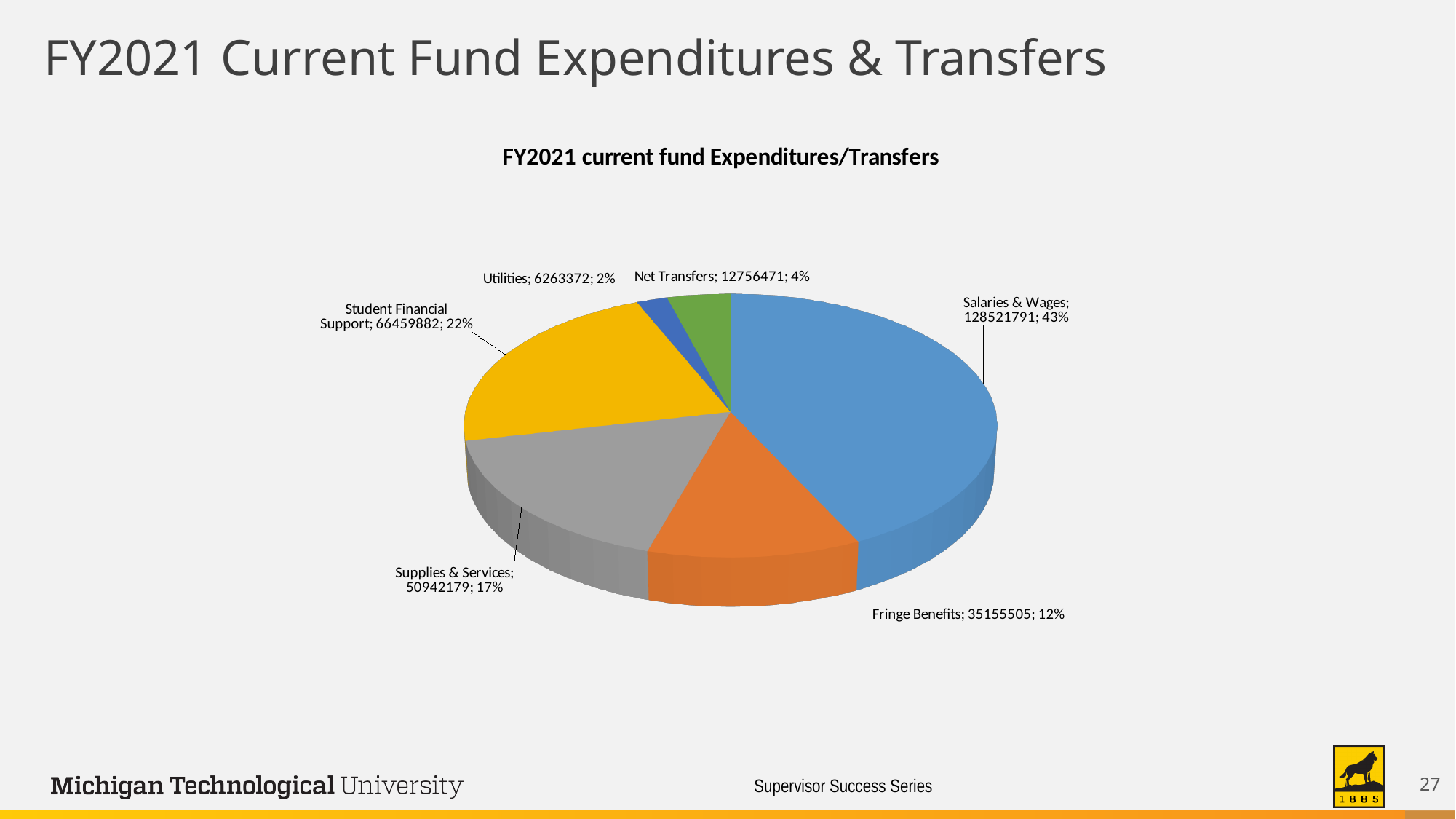
What is the difference between the values for Supplies & Services and Fringe Benefits? 15786674 What is the value for Supplies & Services? 50942179 What is the value for Salaries & Wages? 128521791 What percentage share does Student Financial Support have? 22% What is the title of the chart? FY2021 current fund Expenditures/Transfers Which category has the smallest slice of the pie? Utilities How many categories are shown in the pie chart? 6 What percentage share does Fringe Benefits have? 12% What kind of chart is shown on the slide? Pie chart Which category has the largest slice of the pie? Salaries & Wages What is the difference between the values for Salaries & Wages and Student Financial Support? 62061909 Which is larger, Net Transfers or Utilities? Net Transfers